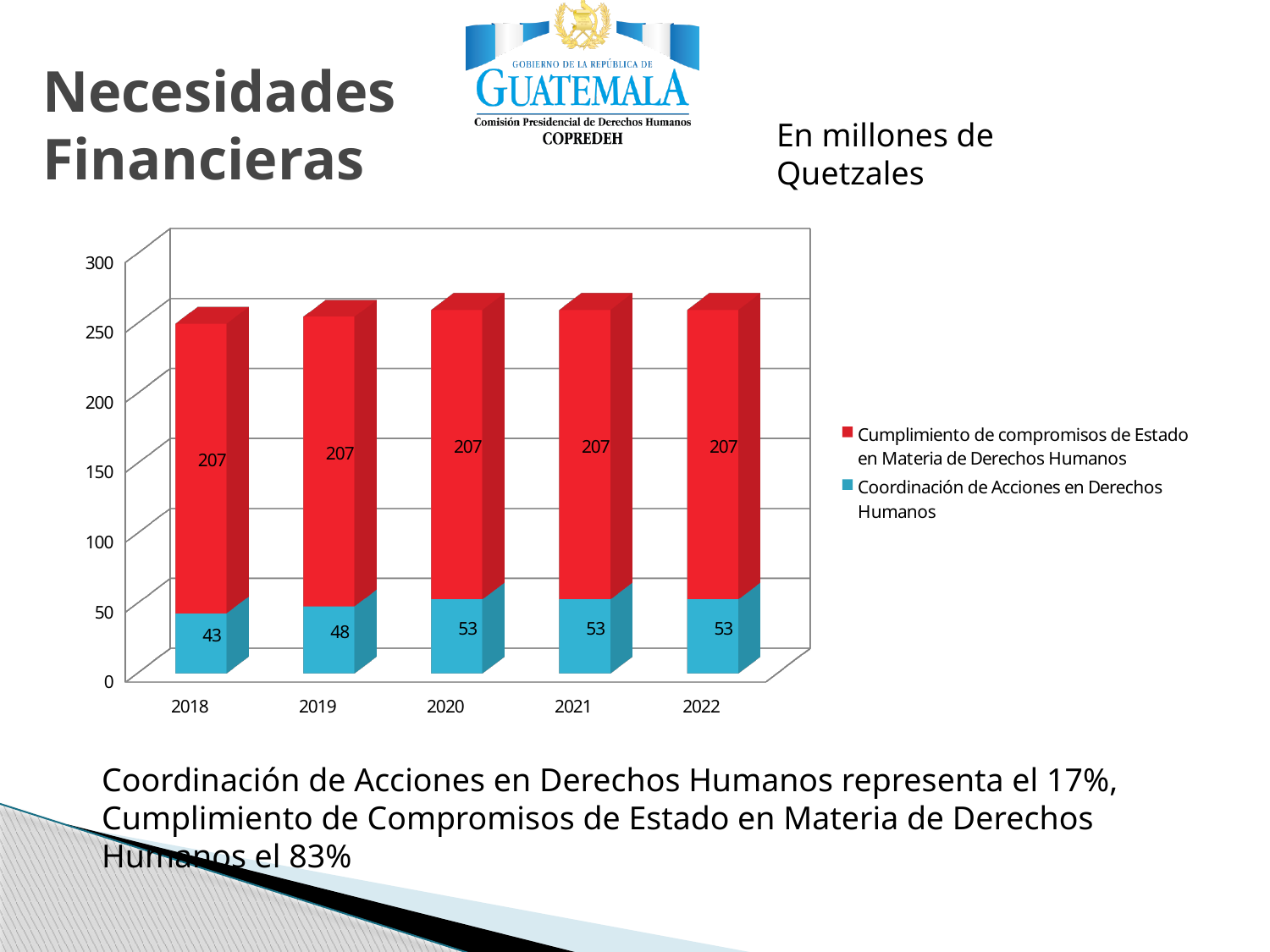
What is the total of the stacked bar for 2018? 250 What is the value for Coordinación de Acciones en Derechos Humanos in 2018? 43 How many series does the chart legend list? 2 What is the difference between the Coordinación de Acciones en Derechos Humanos values for 2020 and 2018? 10 Which year has the lowest value for Coordinación de Acciones en Derechos Humanos? 2018 What is the value for Coordinación de Acciones en Derechos Humanos in 2019? 48 Which is larger in 2021: Cumplimiento de compromisos de Estado en Materia de Derechos Humanos or Coordinación de Acciones en Derechos Humanos? Cumplimiento de compromisos de Estado en Materia de Derechos Humanos What is the value for Cumplimiento de compromisos de Estado en Materia de Derechos Humanos in 2020? 207 How many years are shown on the x axis of the chart? 5 What kind of chart is shown on the slide? Stacked bar chart Does the value for Coordinación de Acciones en Derechos Humanos rise or fall from 2018 to 2020? Rise What is the total of the stacked bar for 2022? 260